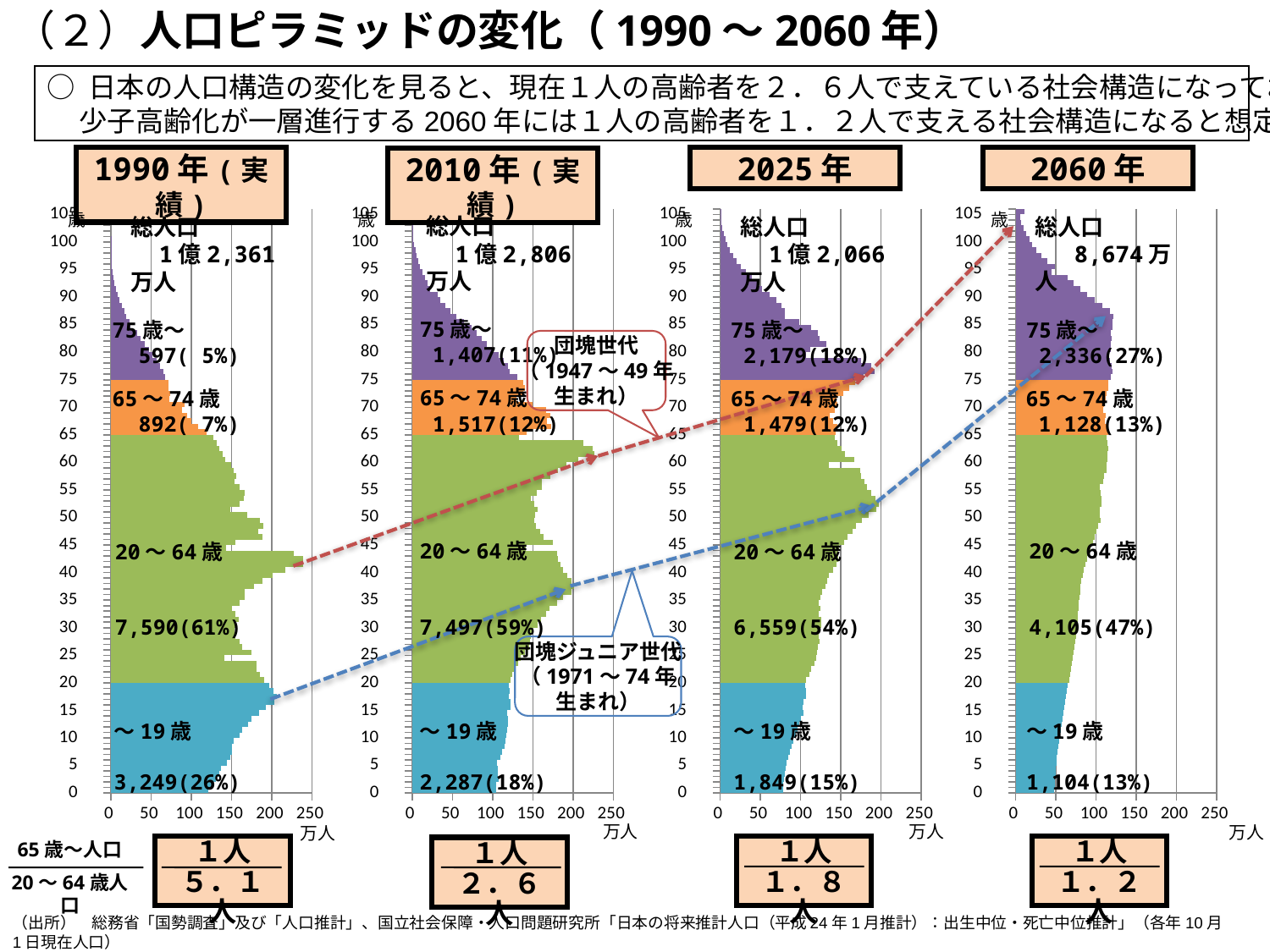
In the 2025年 chart, what is the total population (総人口) shown? 1億2,066万人 What kind of chart is used to show the population pyramids? Bar chart Across the four charts, which year has the largest 20～64歳 population? 1990年 Across the four charts, which year has the smallest ～19歳 population? 2060年 What is the difference between the 75歳～ population in the 2025年 chart (2,179) and in the 1990年 chart (597)? 1,582 In the 1990年 chart, what is the value shown for the 20～64歳 group? 7,590(61%) Does the share of the ～19歳 group rise or fall from the 1990年 chart to the 2060年 chart? Fall How many population pyramid charts are shown on the slide? 4 Which is larger: the 65～74歳 population in the 2010年 chart or in the 2025年 chart? 2010年 In the 2060年 chart, what is the value shown for the 75歳～ group? 2,336(27%) In the 2060年 chart, what is the value shown for the 65～74歳 group? 1,128(13%) In the 2010年 chart, what is the value shown for the ～19歳 group? 2,287(18%)